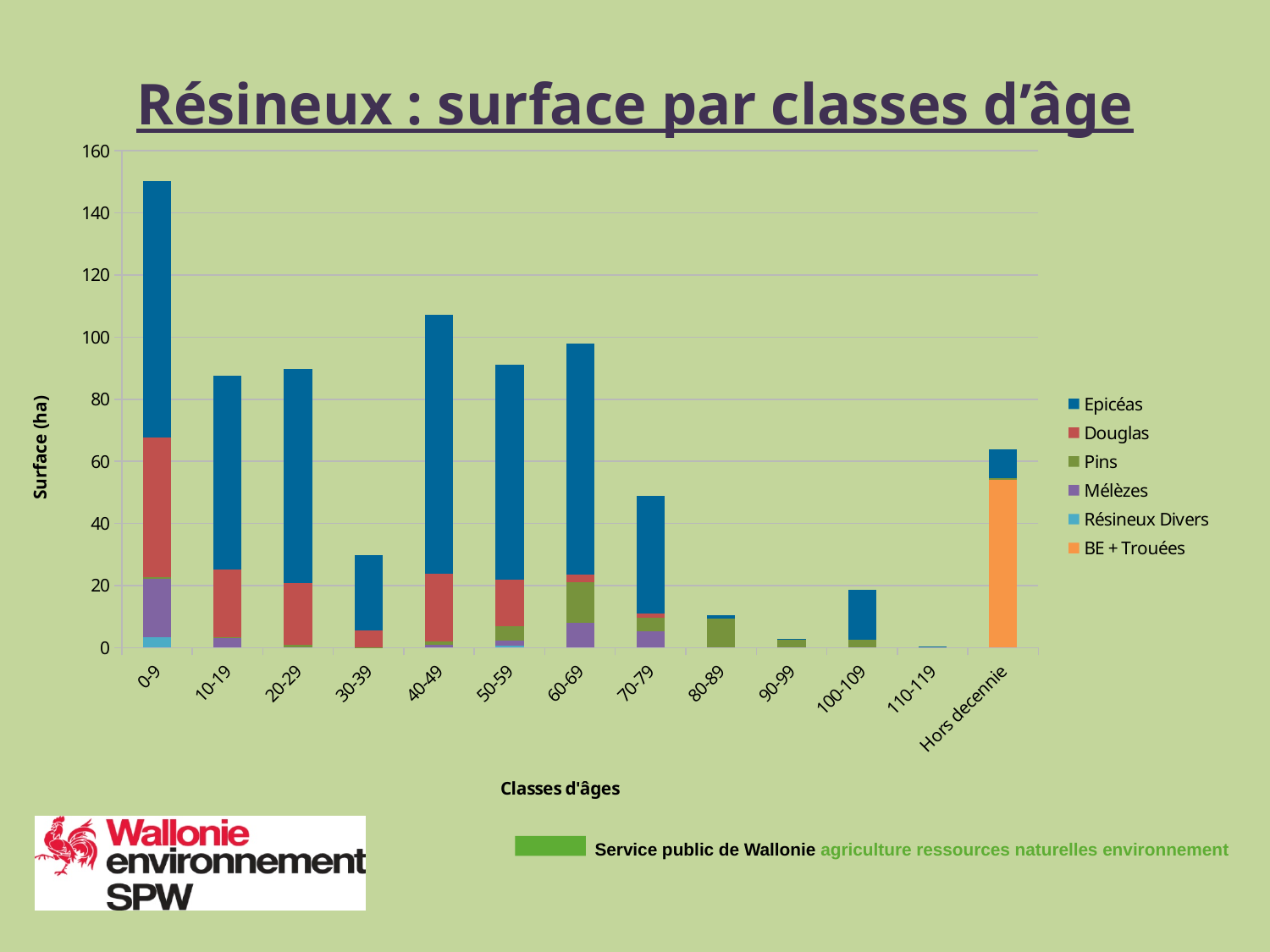
Is the total surface for the 30-39 class greater or less than 40? less How many age classes are shown on the x axis? 13 Is the total surface for the 0-9 class greater or less than 140? greater Which has a larger total surface, the 0-9 class or the 10-19 class? 0-9 Which series is shown in orange in the legend? BE + Trouées Which age class has the highest total surface? 0-9 What is the title of the chart? Résineux : surface par classes d'âge Which age class has the lowest total surface? 110-119 Is the total surface for the 40-49 class greater or less than 100? greater How many series does the legend list? 6 What kind of chart is shown on the slide? Stacked bar chart